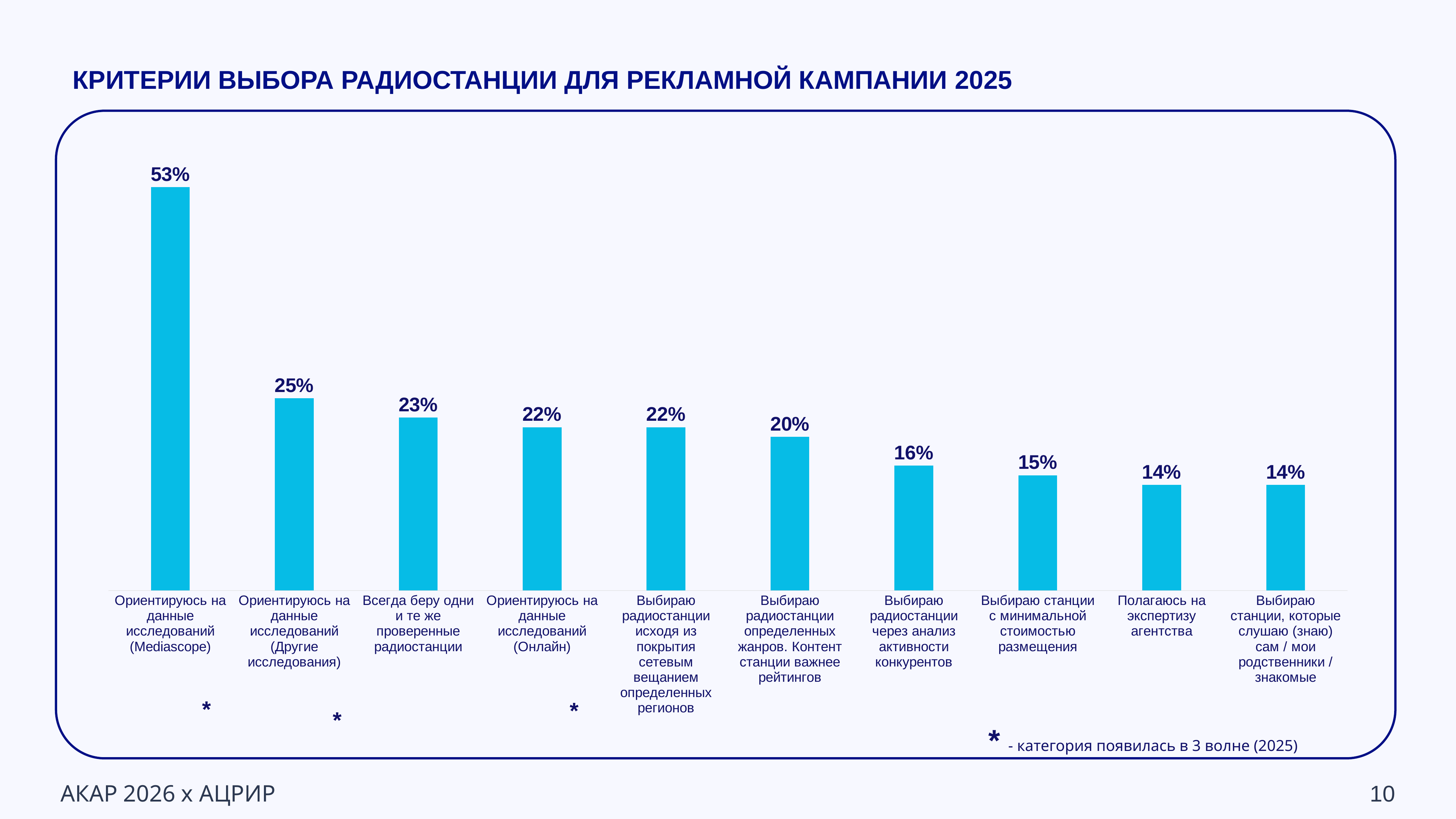
What is the value for «Ориентируюсь на данные исследований (Mediascope)»? 53% Which is larger: the value for «Ориентируюсь на данные исследований (Онлайн)» or the value for «Выбираю радиостанции через анализ активности конкурентов»? Ориентируюсь на данные исследований (Онлайн) Which category has the highest value? Ориентируюсь на данные исследований (Mediascope) What is the value for «Ориентируюсь на данные исследований (Другие исследования)»? 25% What is the value for «Полагаюсь на экспертизу агентства»? 14% What is the title of the chart on the slide? КРИТЕРИИ ВЫБОРА РАДИОСТАНЦИИ ДЛЯ РЕКЛАМНОЙ КАМПАНИИ 2025 What kind of chart is shown on the slide? Bar chart What is the value for «Выбираю радиостанции через анализ активности конкурентов»? 16% What is the difference between the values for «Выбираю радиостанции определенных жанров. Контент станции важнее рейтингов» and «Выбираю станции с минимальной стоимостью размещения»? 5% What is the value for «Всегда беру одни и те же проверенные радиостанции»? 23% What is the difference between the values for «Ориентируюсь на данные исследований (Mediascope)» and «Ориентируюсь на данные исследований (Другие исследования)»? 28% How many categories are shown in the chart? 10